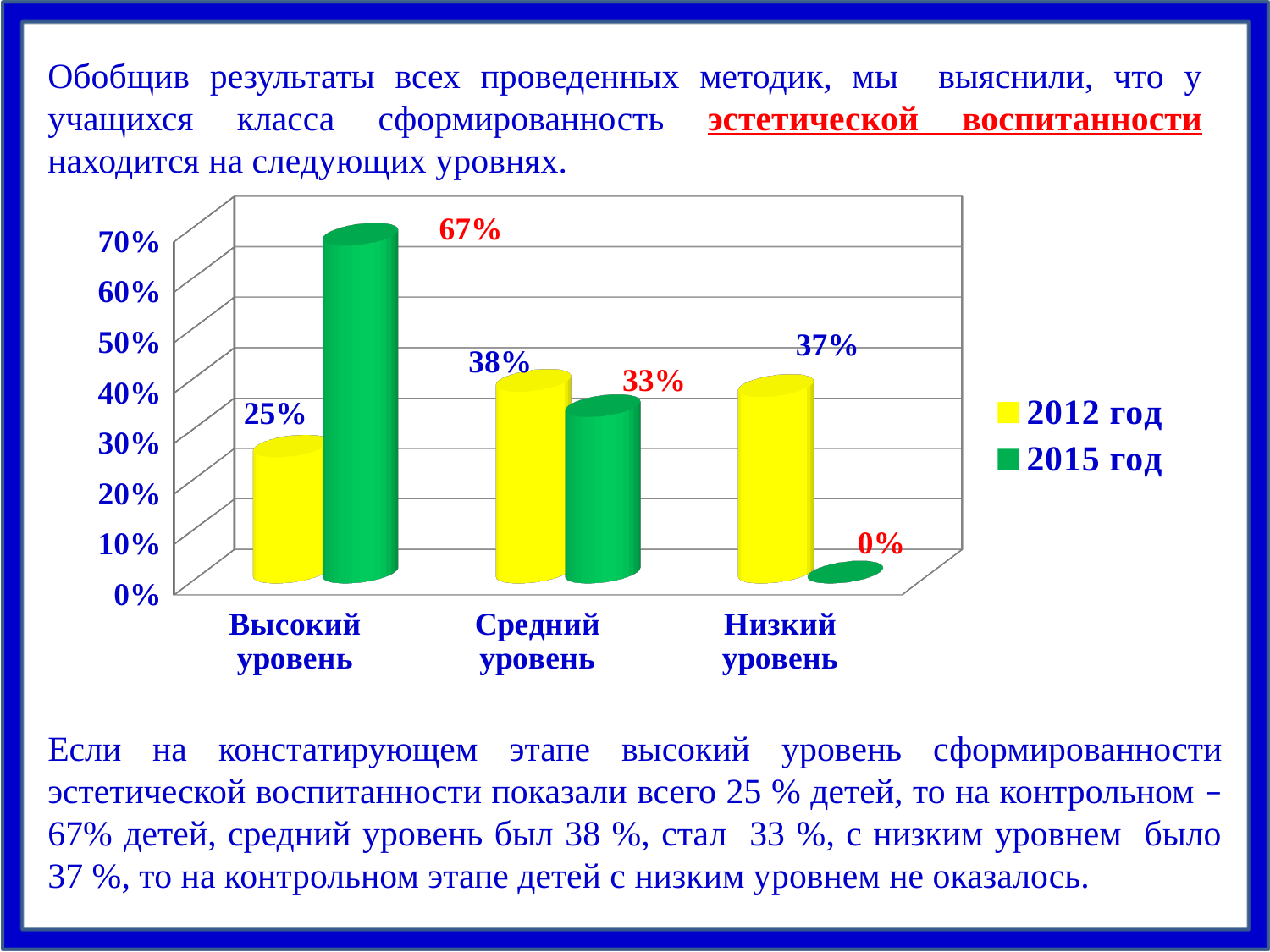
How many categories are shown on the x axis? 3 What is the value for Низкий уровень in the 2012 год series? 37% What is the difference between the 2015 год and 2012 год values for Высокий уровень? 42% What is the value for Высокий уровень in the 2015 год series? 67% What is the value for Высокий уровень in the 2012 год series? 25% Which category has the highest value in the 2015 год series? Высокий уровень Which is larger for Средний уровень: the 2012 год value or the 2015 год value? 2012 год How many series does the legend list? 2 What is the value for Средний уровень in the 2015 год series? 33% Which category has the lowest value in the 2012 год series? Высокий уровень What colour represents the 2015 год series? Green What kind of chart is shown on the slide? Bar chart